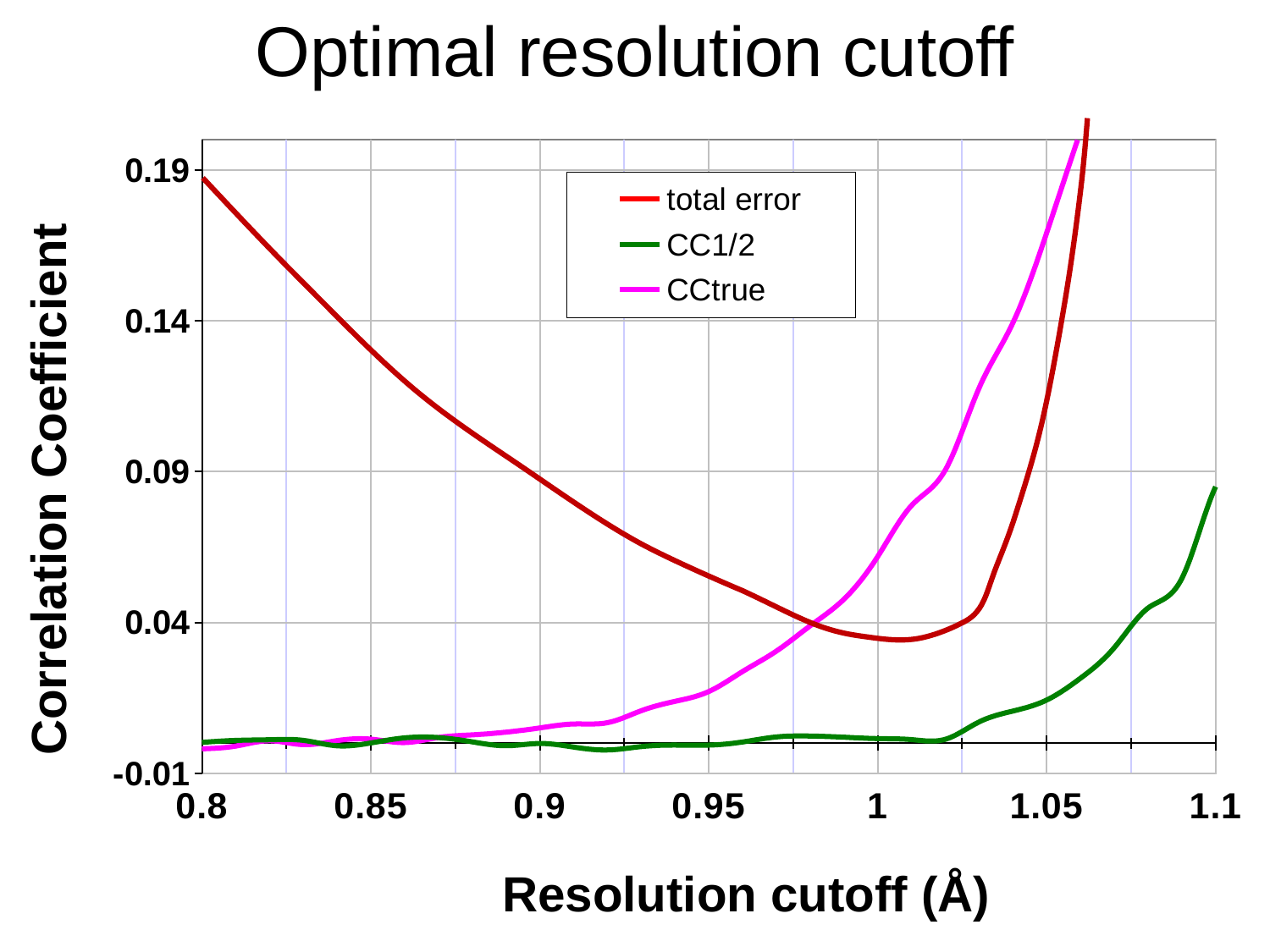
What is the title of the chart? Optimal resolution cutoff Which series has the lowest value at a resolution cutoff of 1.05? CC1/2 Does the CCtrue series generally rise or fall as the resolution cutoff increases from 0.8 to 1.05? rise At a resolution cutoff of 1.05, which series has the larger value, CCtrue or total error? CCtrue Is the value of total error at a resolution cutoff of 0.95 greater or less than 0.04? greater Is the value of CCtrue at a resolution cutoff of 1.05 greater or less than 0.14? greater Is the value of total error at a resolution cutoff of 0.85 greater or less than 0.14? less How many series does the legend list? 3 At a resolution cutoff of 0.9, which series has the larger value, total error or CCtrue? total error What is the label of the x axis? Resolution cutoff (Å) What kind of chart is shown on the slide? line chart